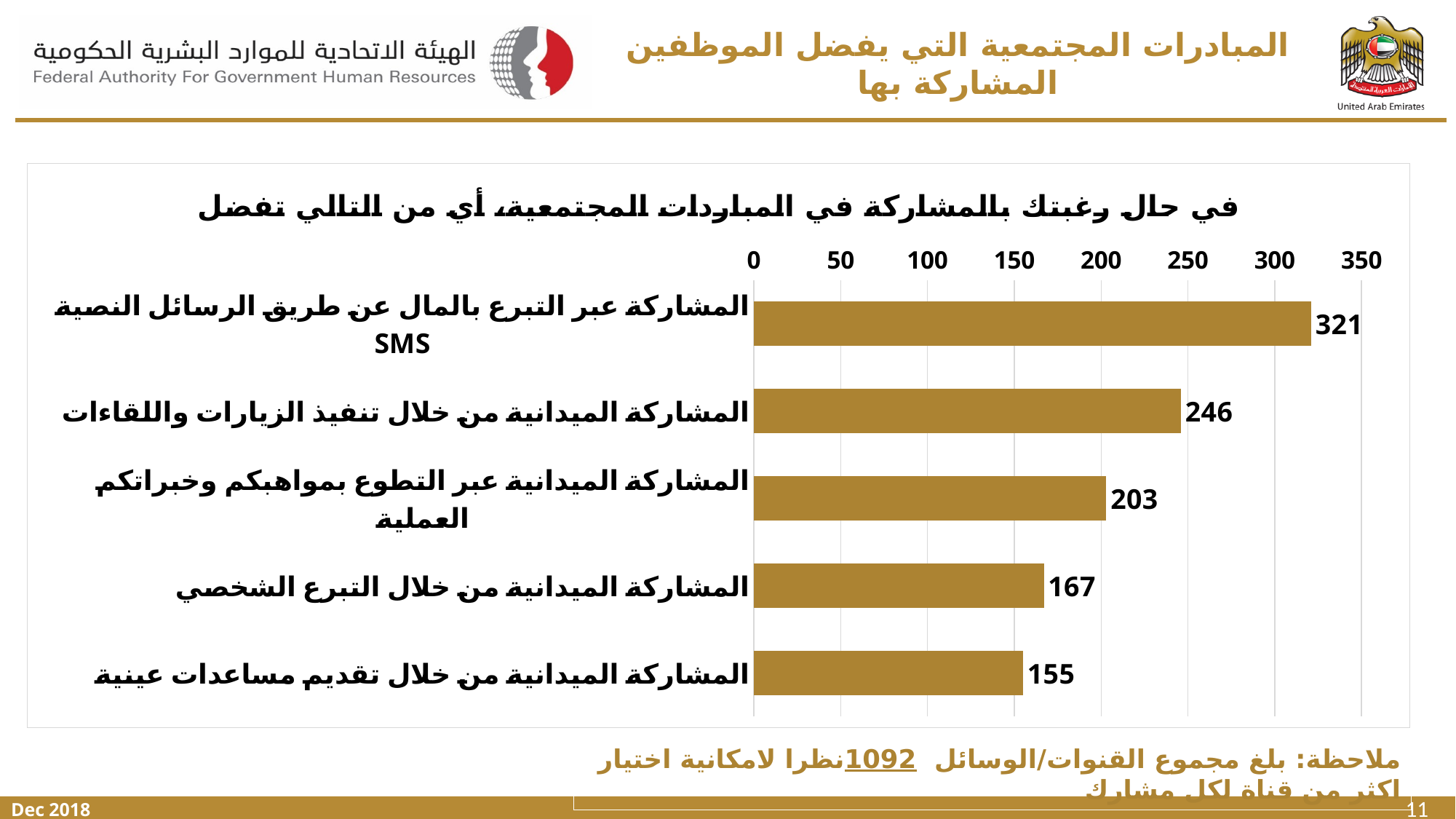
Which category has the highest value? المشاركة عبر التبرع بالمال عن طريق الرسائل النصية SMS What is the maximum value shown on the chart's horizontal axis? 350 What type of chart is shown on the slide? Bar chart How many categories (bars) does the chart show? 5 What is the value for المشاركة الميدانية عبر التطوع بمواهبكم وخبراتكم العملية? 203 Which category has the lowest value? المشاركة الميدانية من خلال تقديم مساعدات عينية What is the value for المشاركة عبر التبرع بالمال عن طريق الرسائل النصية SMS? 321 What is the value for المشاركة الميدانية من خلال التبرع الشخصي? 167 What is the value for المشاركة الميدانية من خلال تنفيذ الزيارات واللقاءات? 246 Which is larger: the value for المشاركة الميدانية من خلال التبرع الشخصي or the value for المشاركة الميدانية من خلال تقديم مساعدات عينية? المشاركة الميدانية من خلال التبرع الشخصي What is the difference between the value for المشاركة عبر التبرع بالمال عن طريق الرسائل النصية SMS and the value for المشاركة الميدانية من خلال تنفيذ الزيارات واللقاءات? 75 What is the value for المشاركة الميدانية من خلال تقديم مساعدات عينية? 155